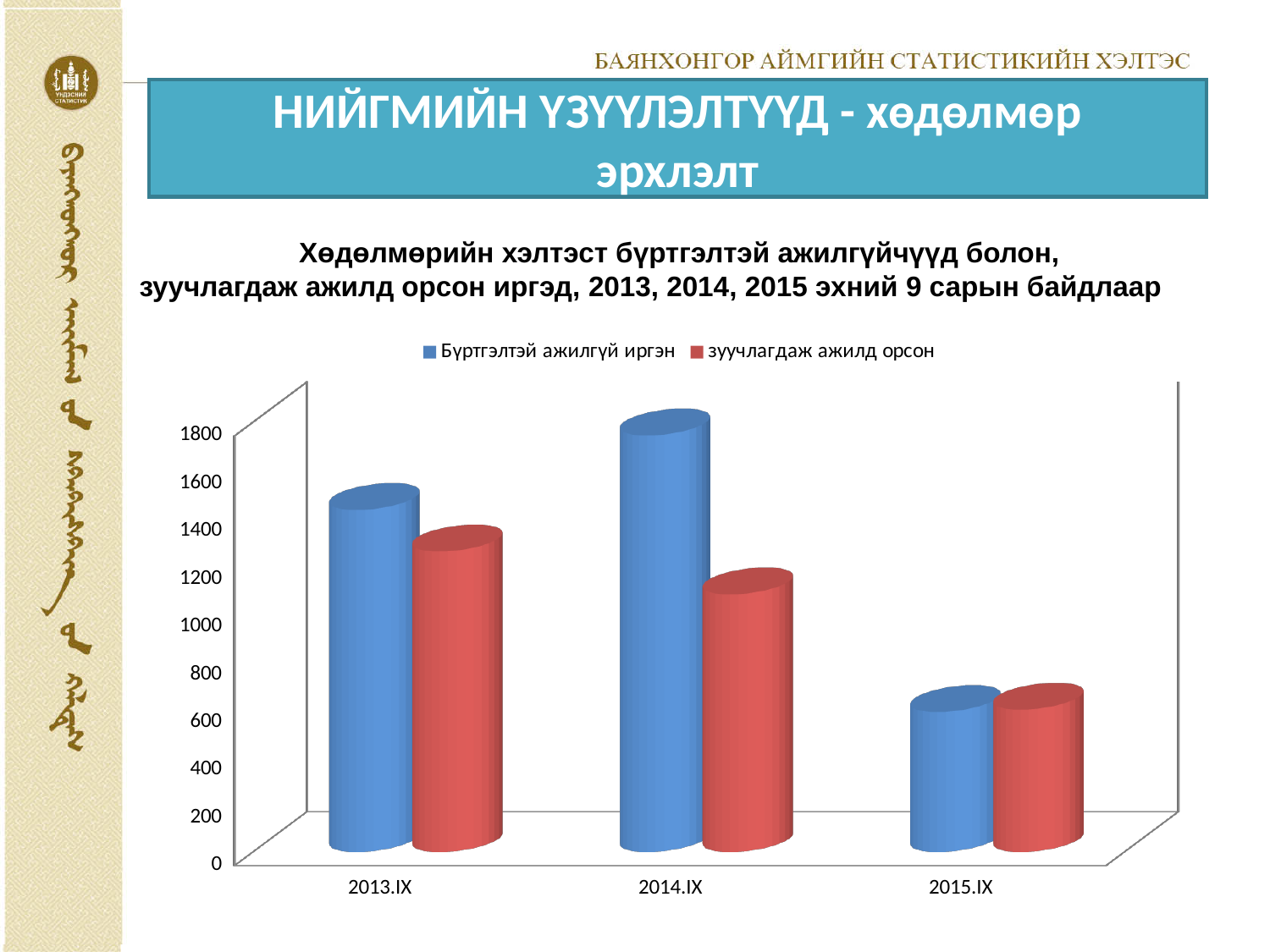
In which period is the value for зуучлагдаж ажилд орсон highest? 2013.IX In 2014.IX, which series has the larger value: Бүртгэлтэй ажилгүй иргэн or зуучлагдаж ажилд орсон? Бүртгэлтэй ажилгүй иргэн Is the value for Бүртгэлтэй ажилгүй иргэн in 2014.IX greater or less than 1600? greater In which period is the value for Бүртгэлтэй ажилгүй иргэн lowest? 2015.IX In which period is the value for Бүртгэлтэй ажилгүй иргэн highest? 2014.IX How many categories are shown on the x axis of the chart? 3 Is the value for зуучлагдаж ажилд орсон in 2014.IX greater or less than 1400? less How many series does the chart legend list? 2 In which period is the value for зуучлагдаж ажилд орсон lowest? 2015.IX What kind of chart is shown on the slide? bar chart Is the value for Бүртгэлтэй ажилгүй иргэн in 2015.IX greater or less than 800? less Does the value for зуучлагдаж ажилд орсон rise or fall from 2013.IX to 2015.IX? fall